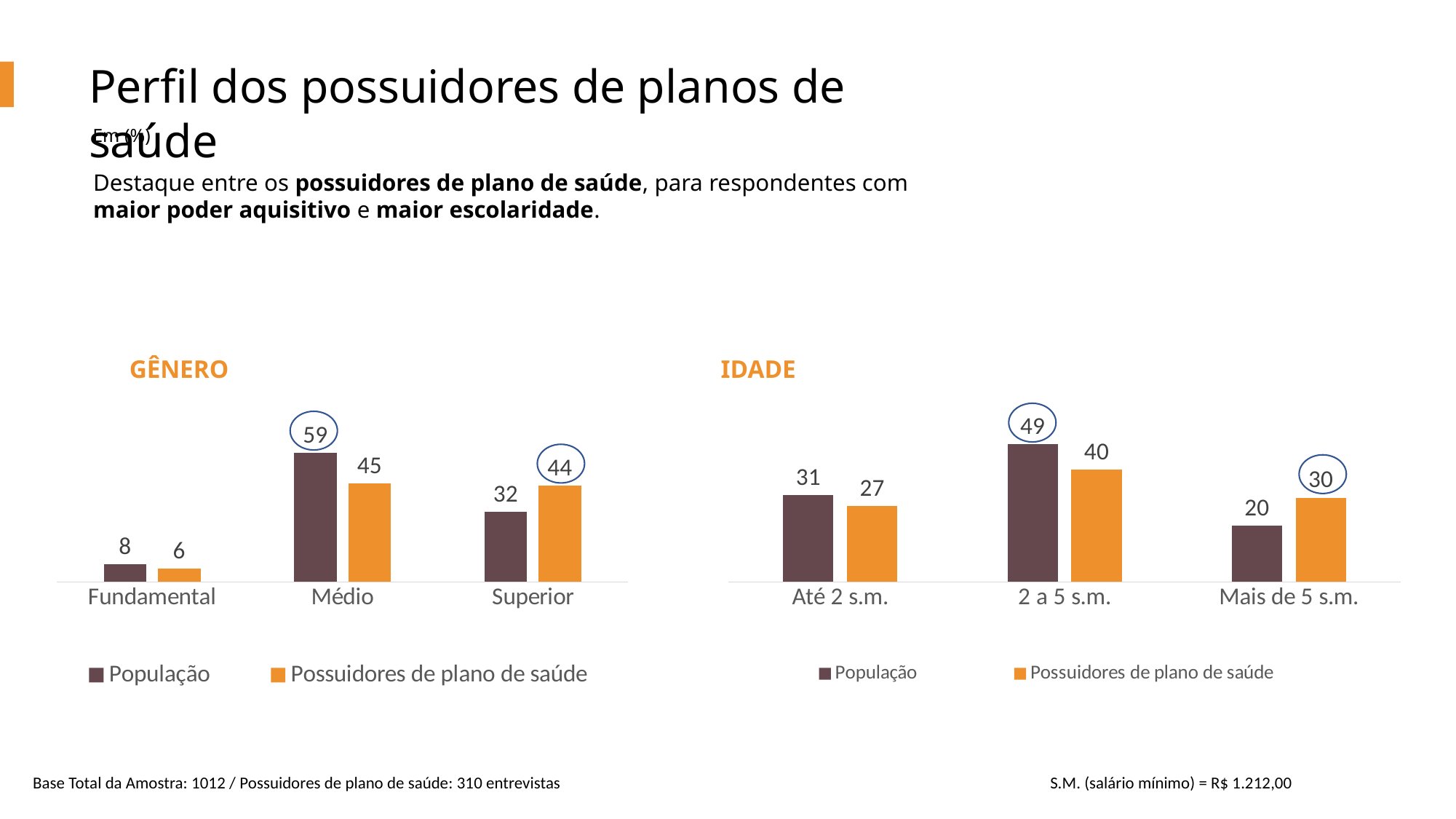
In the right chart (labelled IDADE), what is the difference between Possuidores de plano de saúde and População in the Mais de 5 s.m. category? 10 In the left chart (labelled GÊNERO), how many categories are shown on the x axis? 3 In the left chart (labelled GÊNERO), what is the value for População in the Médio category? 59 In the right chart (labelled IDADE), which category has the highest value for Possuidores de plano de saúde? 2 a 5 s.m. In the right chart (labelled IDADE), what is the value for População in the 2 a 5 s.m. category? 49 In the left chart (labelled GÊNERO), what is the value for Possuidores de plano de saúde in the Superior category? 44 What type of chart is the right chart (labelled IDADE)? Bar chart In the left chart (labelled GÊNERO), which category has the lowest value for Possuidores de plano de saúde? Fundamental In the left chart (labelled GÊNERO), what is the difference between População and Possuidores de plano de saúde in the Médio category? 14 In the right chart (labelled IDADE), how many series does the legend list? 2 In the left chart (labelled GÊNERO), which is larger in the Superior category: População or Possuidores de plano de saúde? Possuidores de plano de saúde In the right chart (labelled IDADE), what is the value for Possuidores de plano de saúde in the Mais de 5 s.m. category? 30